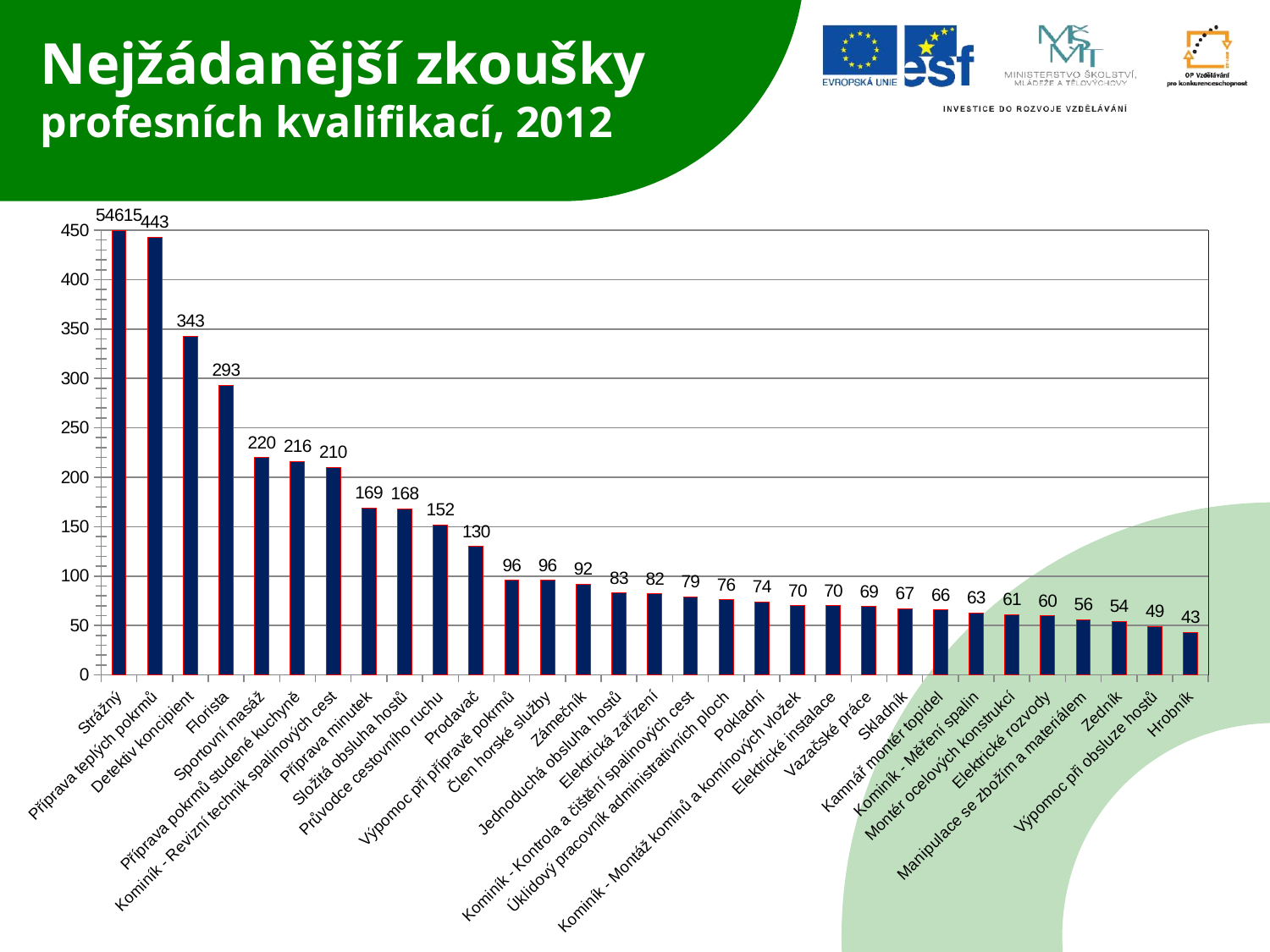
What is the value for Florista? 293 Is the value for Strážný greater or less than 400? greater Do the values rise or fall from left to right along the x axis? fall Which has a larger value, Prodavač or Zámečník? Prodavač Which category has the lowest value? Hrobník What is the value for Hrobník? 43 What is the difference between the values for Florista and Sportovní masáž? 73 What is the value for Detektiv koncipient? 343 What kind of chart is shown on the slide? bar chart What is the value for Zedník? 54 What is the value for Příprava teplých pokrmů? 443 Which category has the highest value? Strážný